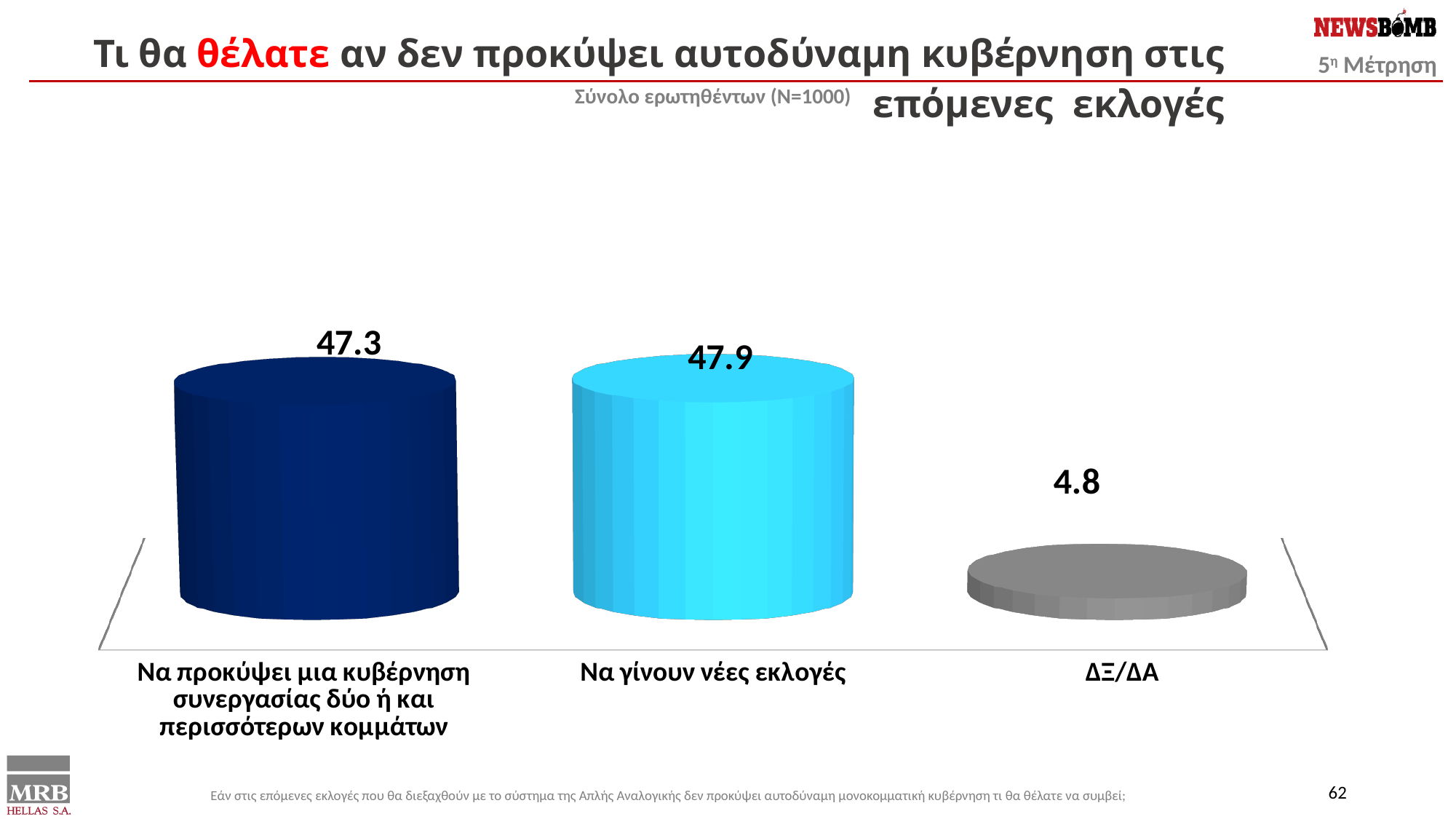
Which category has the lowest value? ΔΞ/ΔΑ Which is larger: the value for 'Να προκύψει μια κυβέρνηση συνεργασίας δύο ή και περισσότερων κομμάτων' or the value for 'ΔΞ/ΔΑ'? Να προκύψει μια κυβέρνηση συνεργασίας δύο ή και περισσότερων κομμάτων What is the difference between the values for 'Να γίνουν νέες εκλογές' and 'Να προκύψει μια κυβέρνηση συνεργασίας δύο ή και περισσότερων κομμάτων'? 0.6 What is the value for 'ΔΞ/ΔΑ'? 4.8 Which category has the highest value? Να γίνουν νέες εκλογές What kind of chart is shown on the slide? Bar chart What is the value for 'Να προκύψει μια κυβέρνηση συνεργασίας δύο ή και περισσότερων κομμάτων'? 47.3 What is the value for 'Να γίνουν νέες εκλογές'? 47.9 What is the difference between the values for 'Να γίνουν νέες εκλογές' and 'ΔΞ/ΔΑ'? 43.1 What colour is the bar for 'ΔΞ/ΔΑ'? Grey What is the total number of respondents (N) stated on the slide? N=1000 How many categories are shown in the chart? 3